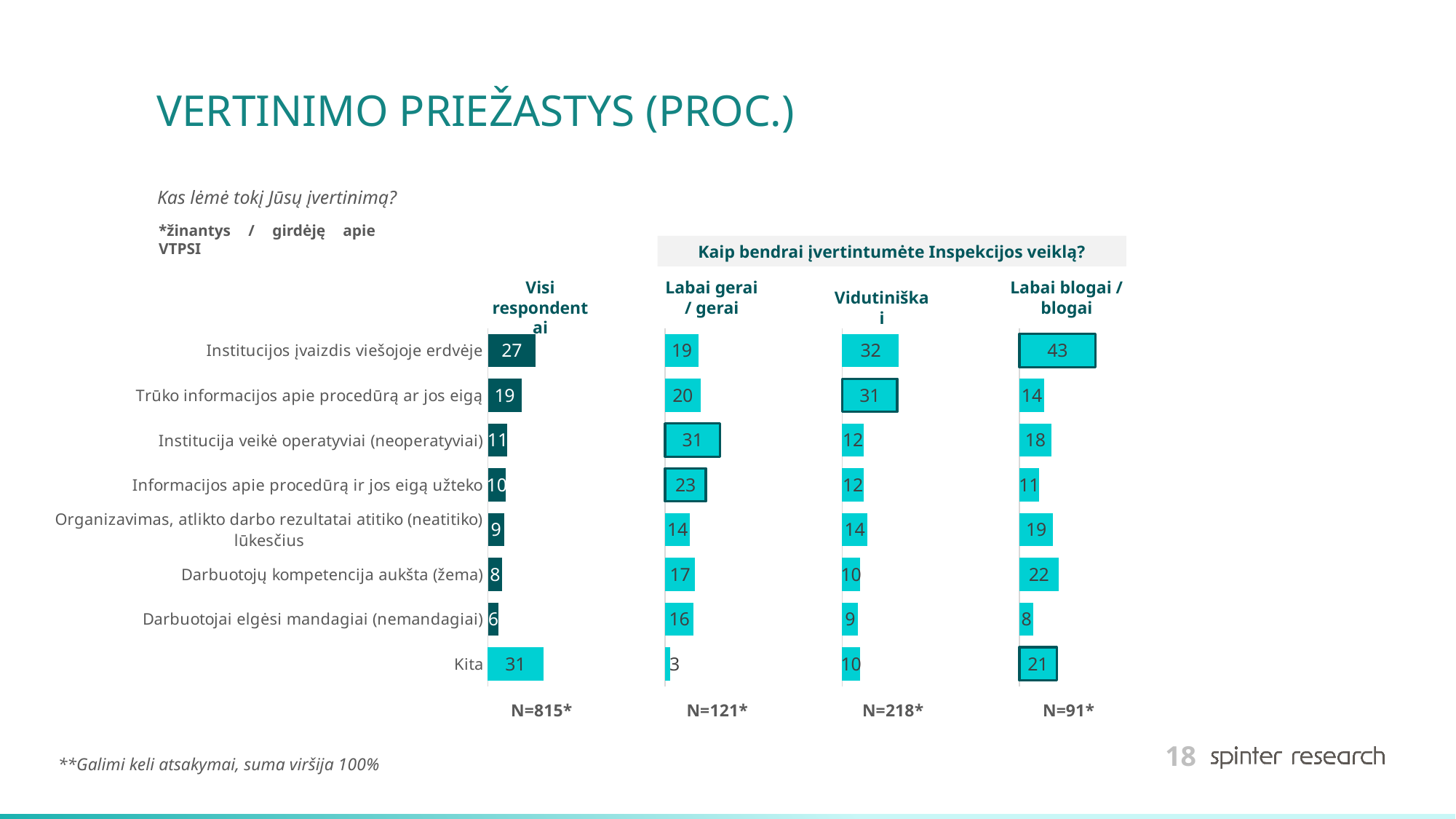
In the "Visi respondentai" chart, what is the value for "Institucijos įvaizdis viešojoje erdvėje"? 27 In the "Labai gerai / gerai" chart, what is the value for "Darbuotojai elgėsi mandagiai (nemandagiai)"? 16 In the "Vidutiniškai" chart, which category has the highest value? Institucijos įvaizdis viešojoje erdvėje In the "Labai blogai / blogai" chart, what is the difference between "Institucijos įvaizdis viešojoje erdvėje" and "Darbuotojų kompetencija aukšta (žema)"? 21 In the "Visi respondentai" chart, what is the value for "Kita"? 31 In the "Labai blogai / blogai" chart, what is the value for "Institucijos įvaizdis viešojoje erdvėje"? 43 In the "Labai gerai / gerai" chart, which category has the highest value? Institucija veikė operatyviai (neoperatyviai) How many categories are plotted in the "Visi respondentai" chart? 8 In the "Vidutiniškai" chart, which is larger: "Trūko informacijos apie procedūrą ar jos eigą" or "Institucija veikė operatyviai (neoperatyviai)"? Trūko informacijos apie procedūrą ar jos eigą What kind of chart is used for the "Labai gerai / gerai" column? Bar chart In the "Labai gerai / gerai" chart, which category has the lowest value? Kita What is the sample size (N) shown under the "Vidutiniškai" chart? N=218*